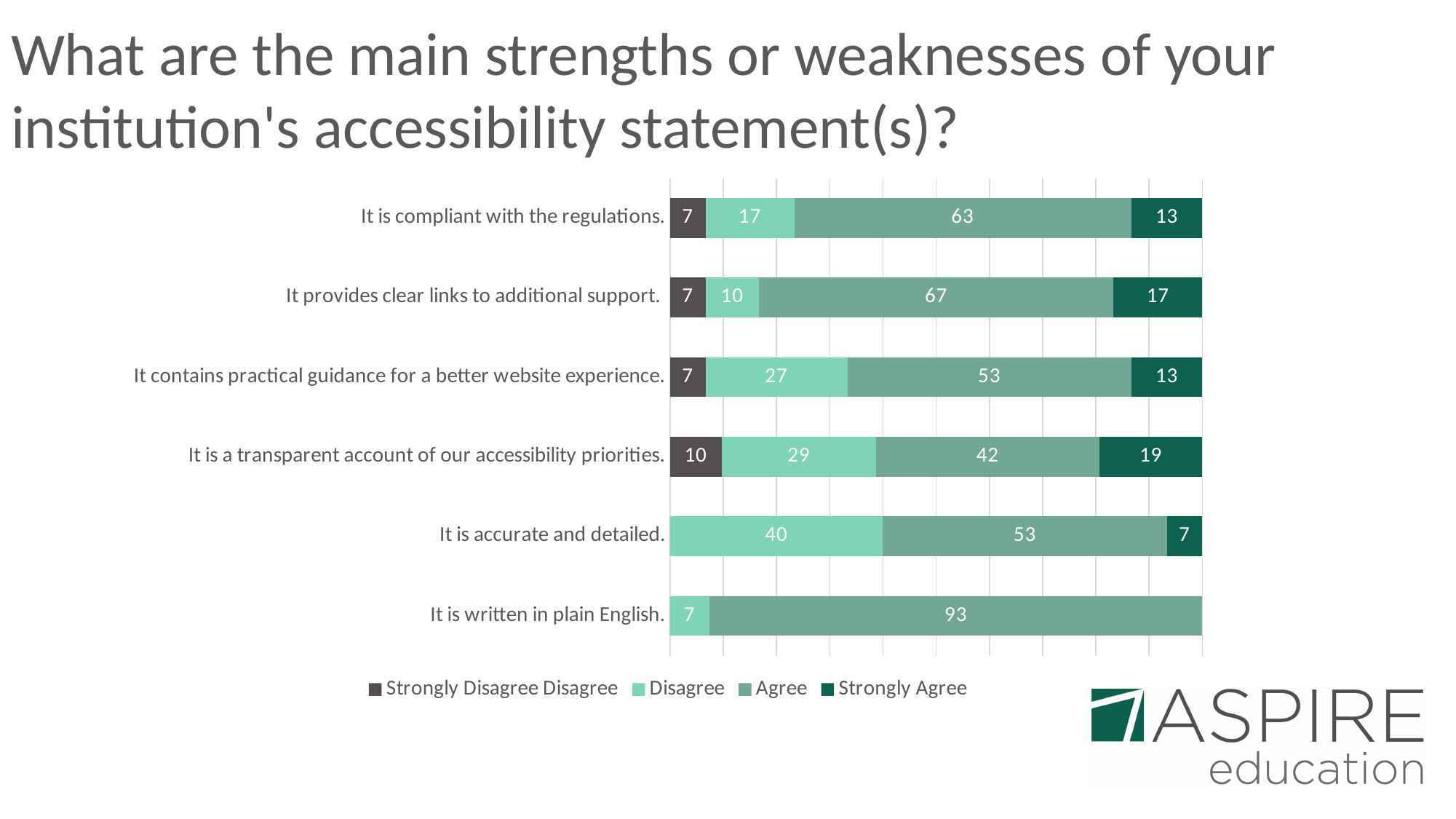
Which statement has the lowest Strongly Agree value? It is written in plain English. What is the Strongly Agree value for "It is a transparent account of our accessibility priorities."? 19 How many statements (categories) are plotted in the chart? 6 Which statement has the highest Strongly Disagree value? It is a transparent account of our accessibility priorities. What is the Disagree value for "It is accurate and detailed."? 40 What is the Agree value for "It is written in plain English."? 93 What kind of chart is shown on the slide? Stacked bar chart Which is larger: the Disagree value for "It contains practical guidance for a better website experience." or the Disagree value for "It is compliant with the regulations."? It contains practical guidance for a better website experience. What is the difference between the Agree values for "It provides clear links to additional support." and "It is compliant with the regulations."? 4 What is the total of the stacked bar for "It is a transparent account of our accessibility priorities."? 100 How many series does the legend list? 4 Which statement has the highest Agree value? It is written in plain English.